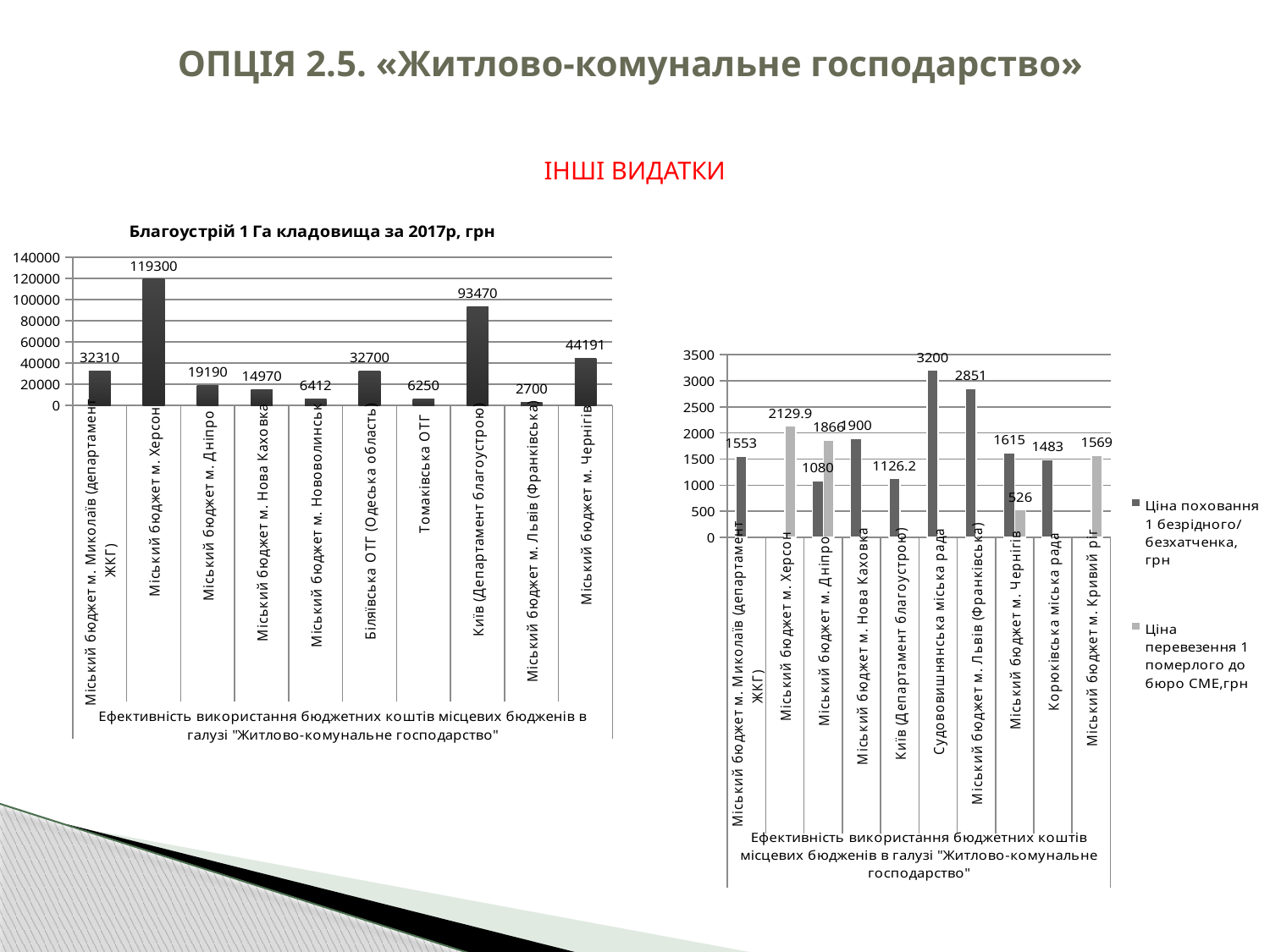
In the chart titled "Благоустрій 1 Га кладовища за 2017р, грн", what is the difference between the values for Міський бюджет м. Чернігів and Міський бюджет м. Миколаїв (департамент ЖКГ)? 11881 In the chart titled "Благоустрій 1 Га кладовища за 2017р, грн", which category has the highest value? Міський бюджет м. Херсон In the chart titled "Благоустрій 1 Га кладовища за 2017р, грн", what is the value for Міський бюджет м. Херсон? 119300 In the chart titled "Благоустрій 1 Га кладовища за 2017р, грн", which is larger: the value for Біляївська ОТГ (Одеська область) or for Міський бюджет м. Дніпро? Біляївська ОТГ (Одеська область) What type of chart is the chart on the right? Bar chart In the chart titled "Благоустрій 1 Га кладовища за 2017р, грн", how many categories are shown? 10 In the chart titled "Благоустрій 1 Га кладовища за 2017р, грн", what is the value for Київ (Департамент благоустрою)? 93470 In the chart on the right, how many series does the legend list? 2 In the chart titled "Благоустрій 1 Га кладовища за 2017р, грн", which category has the lowest value? Міський бюджет м. Львів (Франківська) In the chart on the right, what is the difference between the two values shown for Міський бюджет м. Дніпро? 786 In the chart on the right, what is the value of "Ціна перевезення 1 померлого до бюро СМЕ, грн" for Міський бюджет м. Чернігів? 526 In the chart on the right, what is the value of "Ціна поховання 1 безрідного/безхатченка, грн" for Судововишнянська міська рада? 3200